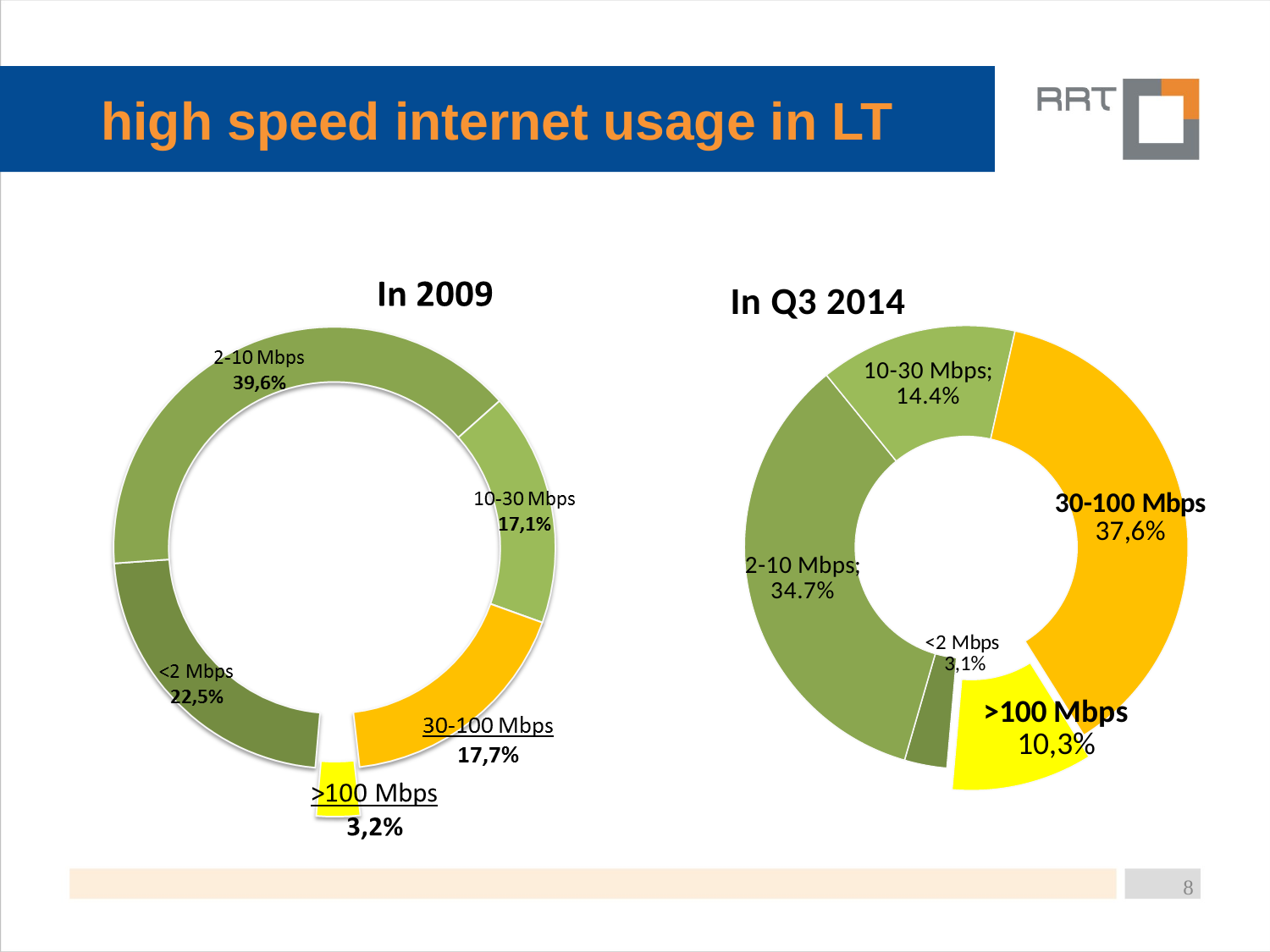
In the 'In Q3 2014' chart, what share is shown for 10-30 Mbps? 14.4% In the 'In Q3 2014' chart, what is the difference between the shares for 30-100 Mbps and >100 Mbps? 27,3 percentage points How many categories does the 'In Q3 2014' chart show? 5 In the 'In Q3 2014' chart, what share is shown for >100 Mbps? 10,3% In the 'In 2009' chart, which category has the largest share? 2-10 Mbps What colour is the >100 Mbps segment in the 'In Q3 2014' chart? Yellow In the 'In 2009' chart, which is larger: the share for <2 Mbps or the share for 30-100 Mbps? <2 Mbps What kind of chart is the 'In 2009' chart? Doughnut chart In the 'In 2009' chart, what share is shown for <2 Mbps? 22,5% In the 'In Q3 2014' chart, which category has the smallest share? <2 Mbps In the 'In Q3 2014' chart, what share is shown for 30-100 Mbps? 37,6% In the 'In 2009' chart, what share is shown for 2-10 Mbps? 39,6%